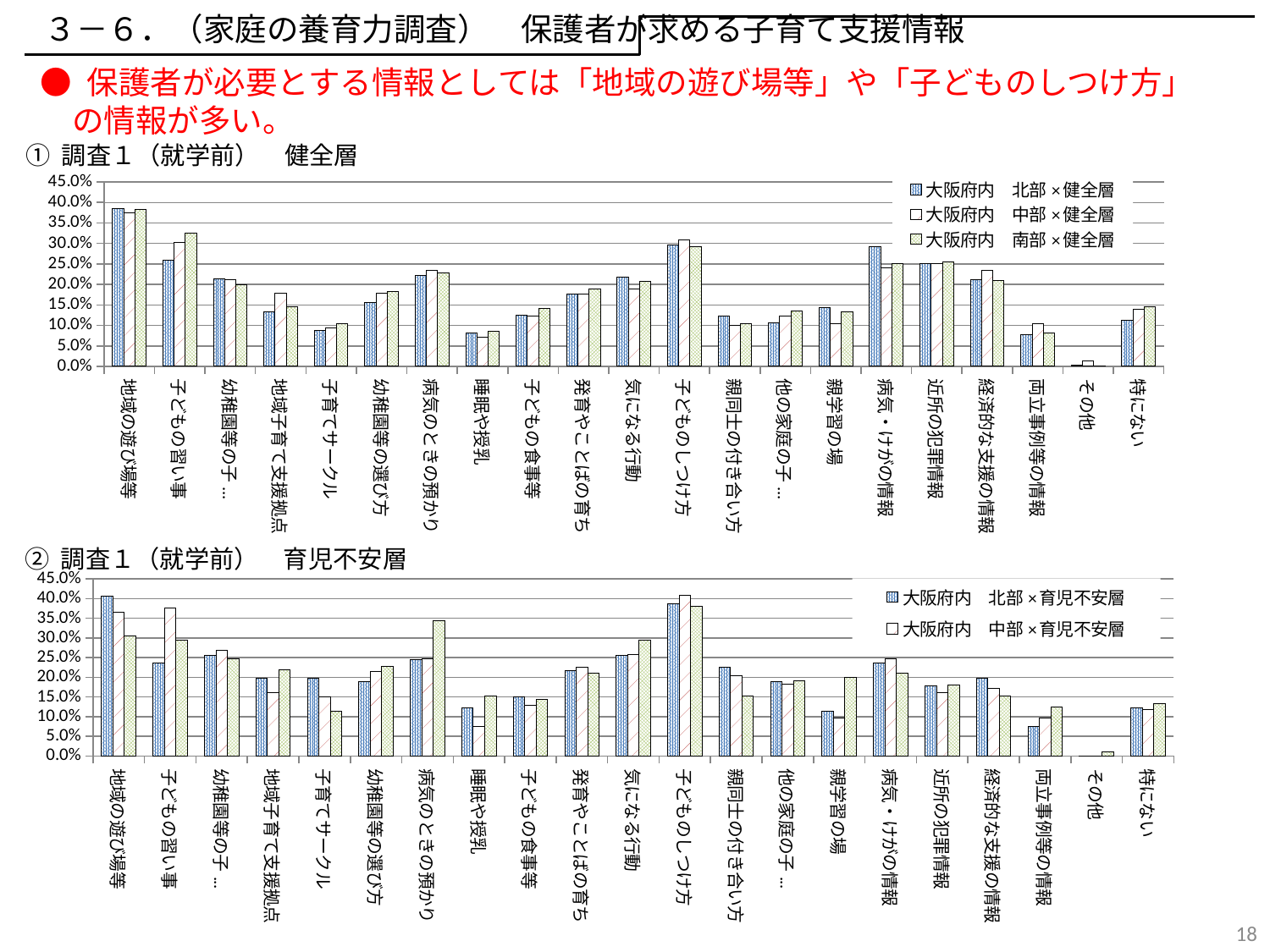
In the bottom chart (② 調査１（就学前） 育児不安層), which category has the lowest values? その他 In the top chart (① 調査１（就学前） 健全層), which category has the lowest values? その他 In the top chart (① 調査１（就学前） 健全層), is the value for 睡眠や授乳 in the 大阪府内 北部×健全層 series greater or less than 10.0%? less How many series does the legend of the top chart (① 調査１（就学前） 健全層) list? 3 How many series does the legend of the bottom chart (② 調査１（就学前） 育児不安層) list? 2 In the top chart (① 調査１（就学前） 健全層), is the value for 地域の遊び場等 in the 大阪府内 北部×健全層 series greater or less than 35.0%? greater In the top chart (① 調査１（就学前） 健全層), for 子どもの習い事, which is larger: 大阪府内 北部×健全層 or 大阪府内 南部×健全層? 大阪府内 南部×健全層 In the top chart (① 調査１（就学前） 健全層), which category has the highest value for 大阪府内 北部×健全層? 地域の遊び場等 How many categories are shown on the x axis of the top chart (① 調査１（就学前） 健全層)? 21 What kind of chart is the top chart titled ① 調査１（就学前） 健全層? bar chart In the bottom chart (② 調査１（就学前） 育児不安層), for 子育てサークル, which is larger: the 大阪府内 北部×育児不安層 bar or the third (green) bar? 大阪府内 北部×育児不安層 In the bottom chart (② 調査１（就学前） 育児不安層), is the value for 子どものしつけ方 in the 大阪府内 中部×育児不安層 series greater or less than 35.0%? greater